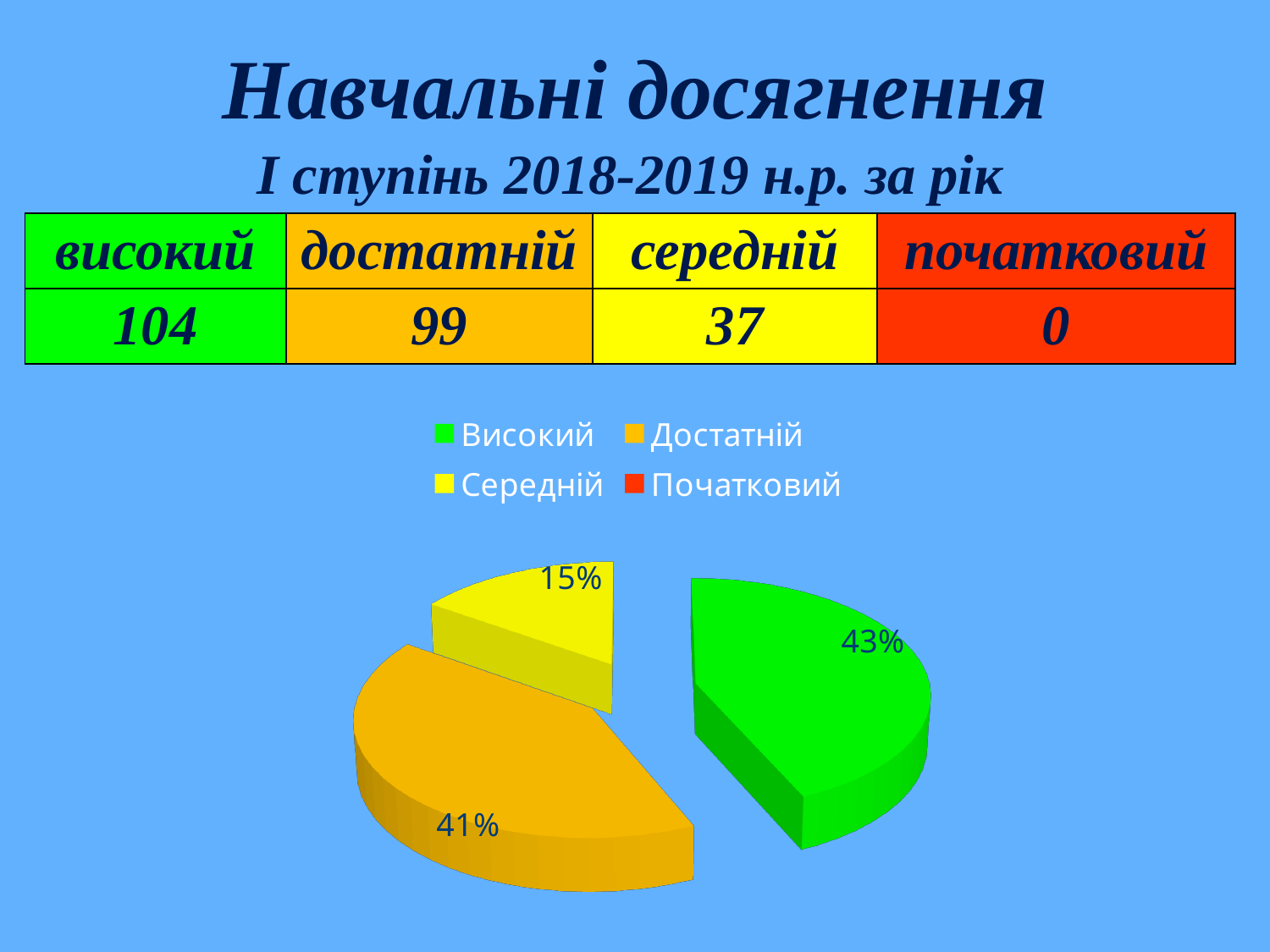
Which is larger, the Високий slice or the Середній slice? Високий What is the difference in percentage points between the Достатній slice and the Середній slice? 26 Which slice of the pie is the largest? Високий What kind of chart is shown on the slide? pie chart How many slices are visible in the pie chart? 3 What share of the pie does the Достатній slice have? 41% Which visible slice of the pie is the smallest? Середній What share of the pie does the Високий slice have? 43% What colour is the Достатній slice in the pie chart? orange What share of the pie does the Середній slice have? 15% How many entries does the legend of the pie chart list? 4 Which legend entry has no visible slice in the pie chart? Початковий